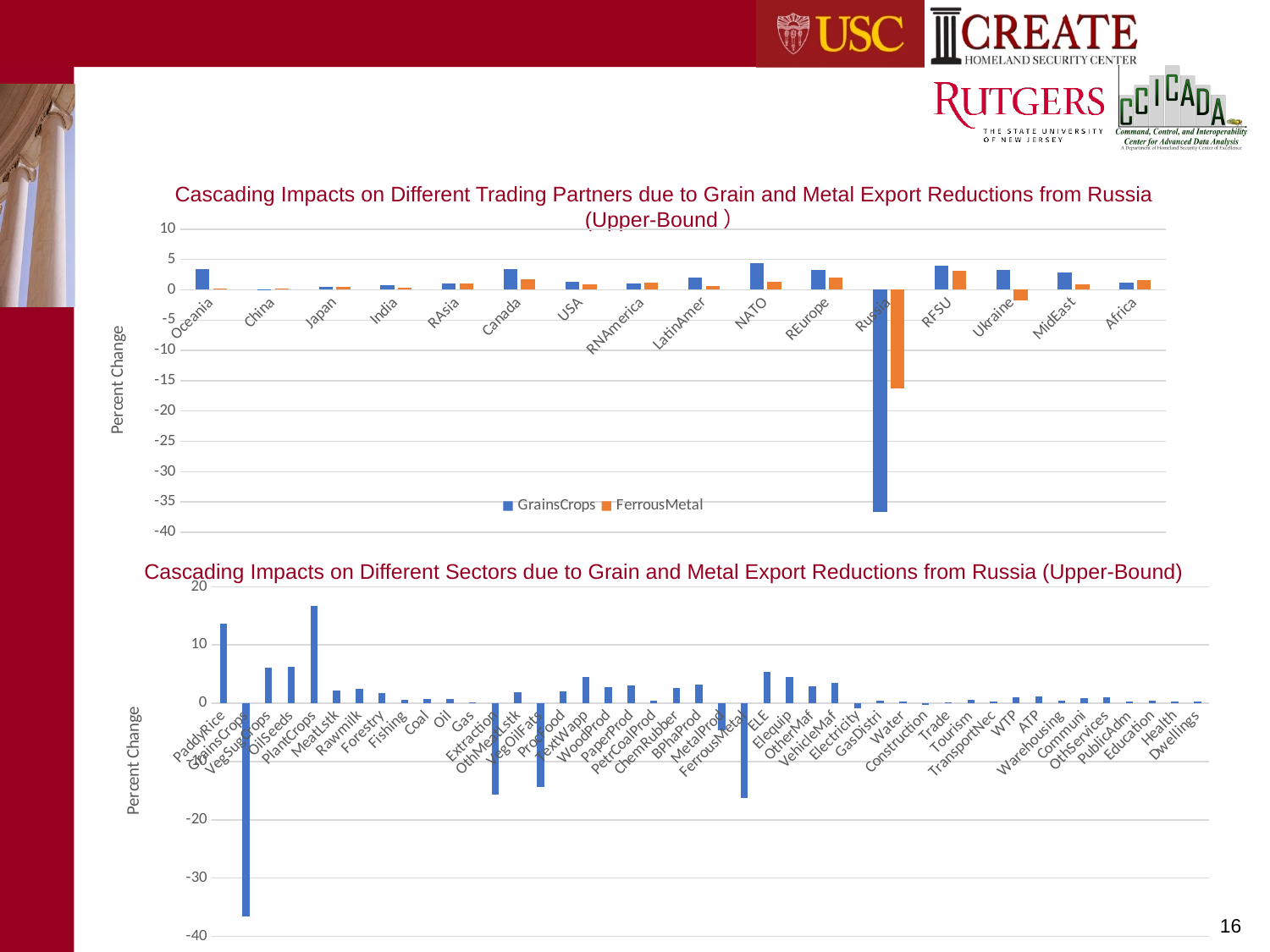
In the top chart on trading partners, which is larger for Russia, the GrainsCrops value or the FerrousMetal value? FerrousMetal In the top chart on trading partners, is the FerrousMetal value for Russia greater or less than -10? less In the bottom chart on sectors, which sector has the lowest value? GrainsCrops In the bottom chart on sectors, which sector has the highest value? PlantCrops In the top chart on trading partners, which trading partner has the lowest FerrousMetal value? Russia In the top chart on trading partners, how many trading partner categories are shown on the x axis? 16 In the top chart on trading partners, which trading partner has the lowest GrainsCrops value? Russia In the top chart on trading partners, how many series does the legend list? 2 In the bottom chart on sectors, is the value for PlantCrops greater or less than 10? greater In the top chart on trading partners, what are the two series named in the legend? GrainsCrops and FerrousMetal In the top chart on trading partners, is the GrainsCrops value for Russia greater or less than -30? less What type of chart is the top chart, 'Cascading Impacts on Different Trading Partners'? bar chart